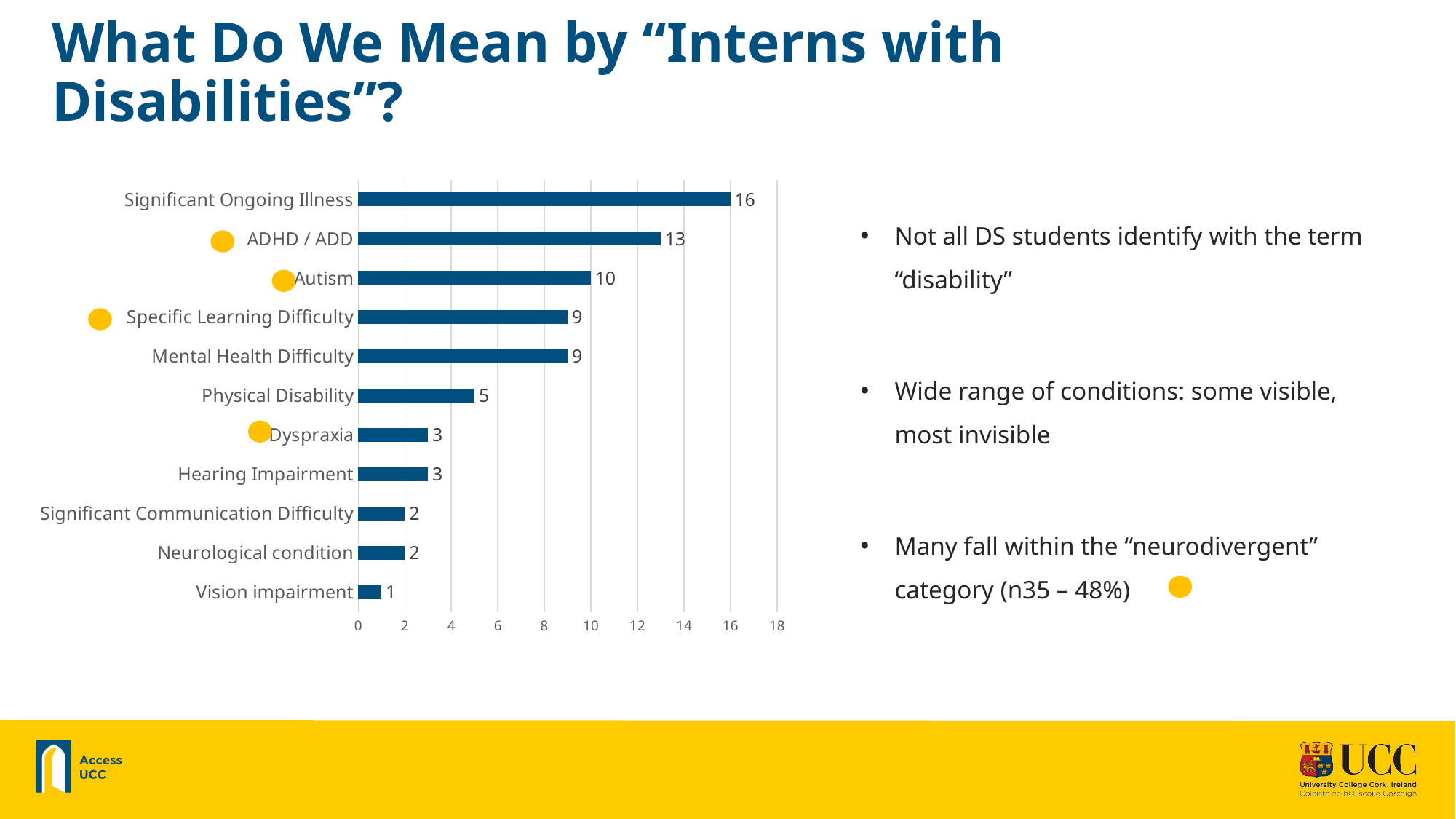
Which category has the highest value? Significant Ongoing Illness Which category has the lowest value? Vision impairment What is the value for Significant Ongoing Illness? 16 What is the value for Vision impairment? 1 Which is larger, the value for Autism or the value for Mental Health Difficulty? Autism What is the value for ADHD / ADD? 13 What is the maximum value shown on the chart's value axis? 18 What kind of chart is shown on the slide? Bar chart What is the value for Physical Disability? 5 What is the difference between the values for Significant Ongoing Illness and ADHD / ADD? 3 What is the difference between the values for Autism and Physical Disability? 5 How many categories are shown in the chart? 11